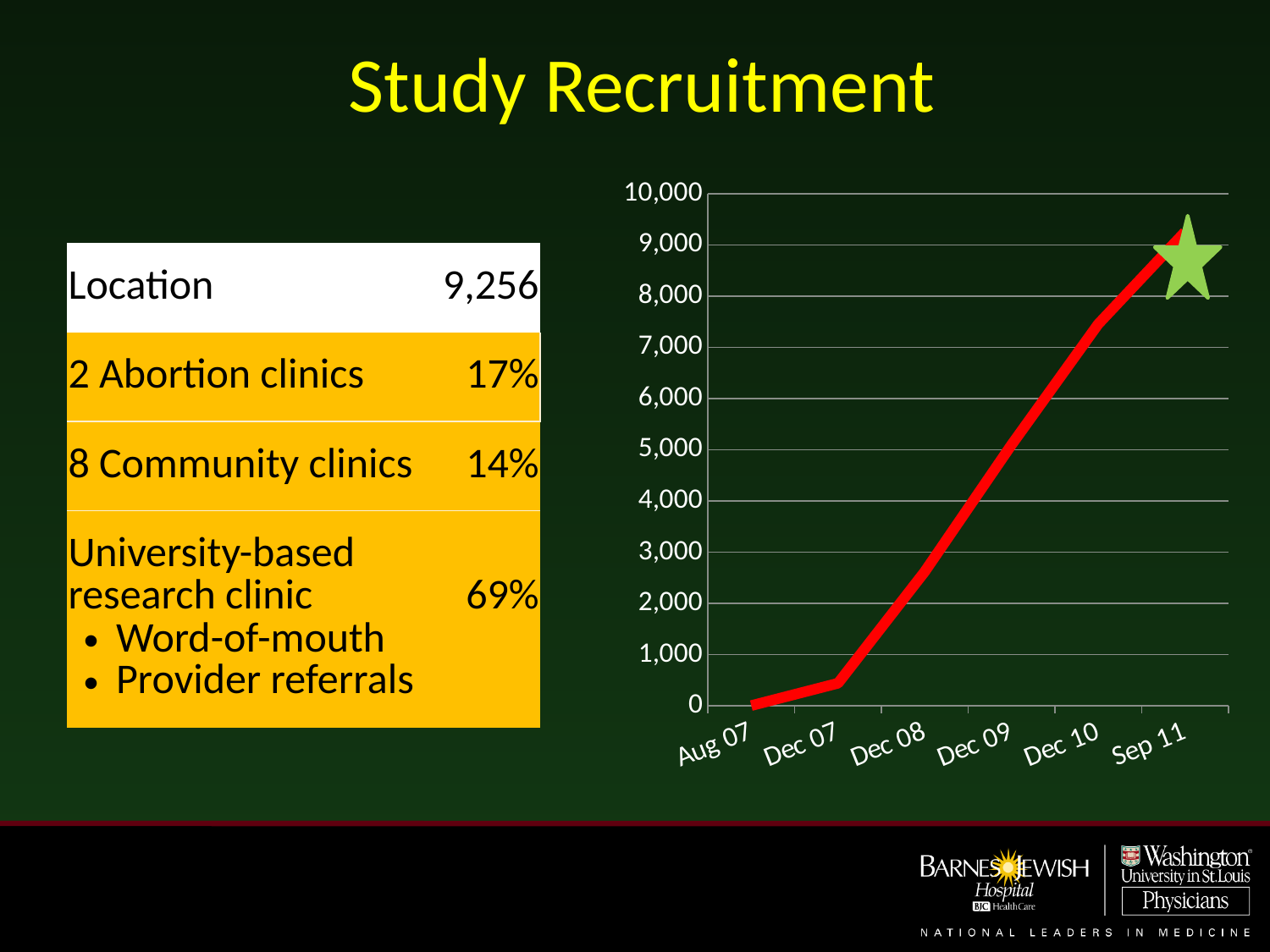
Does the line in the chart rise or fall from Aug 07 to Sep 11? rise Is the value at Dec 09 greater or less than 4,000? greater How many time points are labelled on the x axis of the chart? 6 What kind of chart is shown on the slide? line chart What is the first label on the x axis of the chart? Aug 07 Is the value at Dec 07 greater or less than 1,000? less Is the value at Dec 08 greater or less than 3,000? less What is the highest tick value shown on the y axis of the chart? 10,000 At which x-axis label does the line reach its highest value? Sep 11 At which x-axis label is the line at its lowest value? Aug 07 Which is larger, the value at Dec 10 or the value at Dec 08? Dec 10